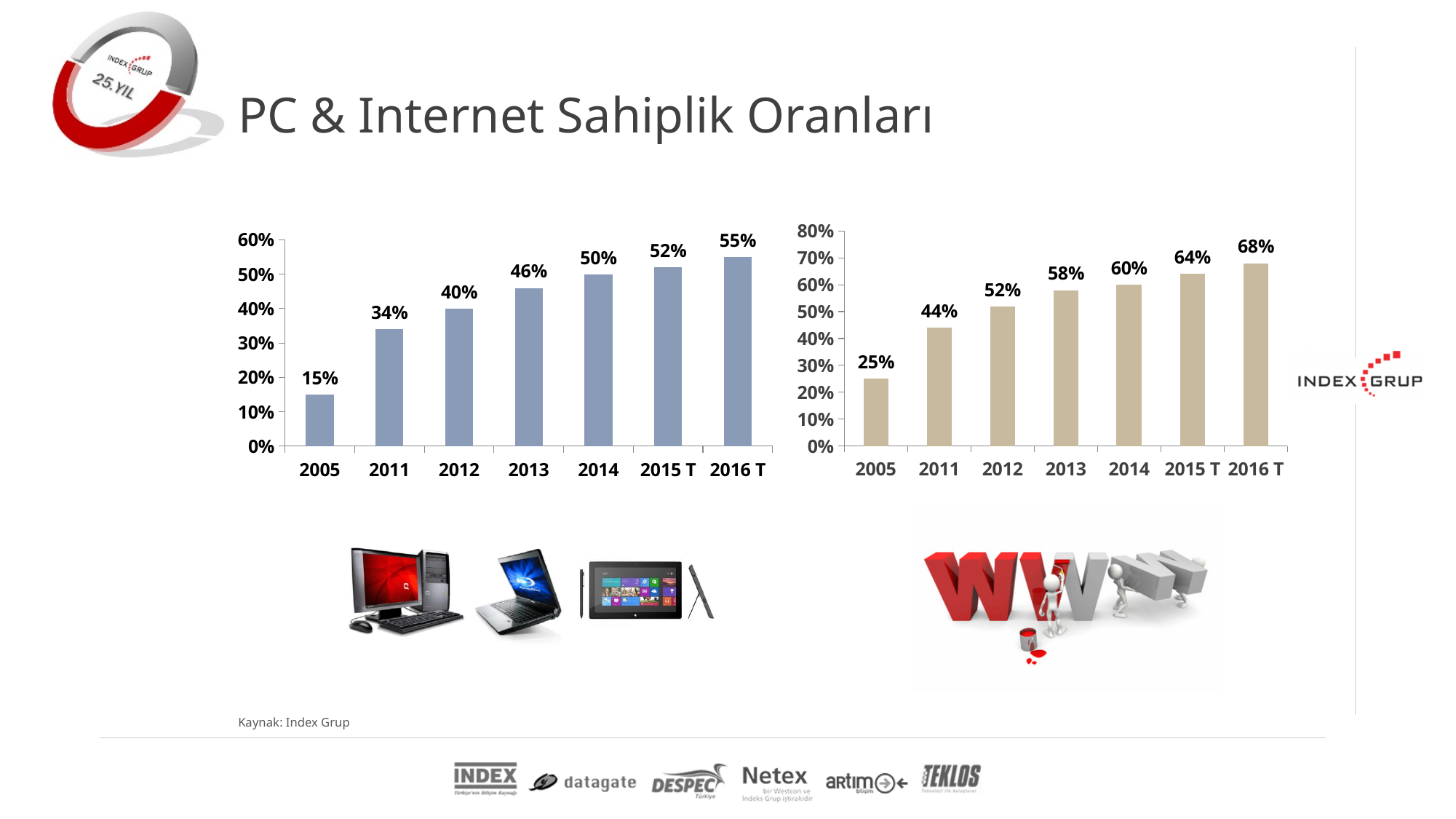
In the left chart, which year has the highest value? 2016 T How many bars does the left chart have? 7 In the left chart, is the value for 2013 greater or less than 40%? greater In the right chart, which year has the lowest value? 2005 In the right chart, which is larger, the value for 2013 or the value for 2012? 2013 In the left chart, what is the difference between the values for 2016 T and 2005? 40% In the right chart, what is the value for 2014? 60% What kind of chart is the right chart? bar chart In the left chart, what is the value for 2005? 15% In the right chart, do the values rise or fall from 2005 to 2016 T? rise In the right chart, what is the difference between the values for 2012 and 2011? 8% What is the title of the slide? PC & Internet Sahiplik Oranları